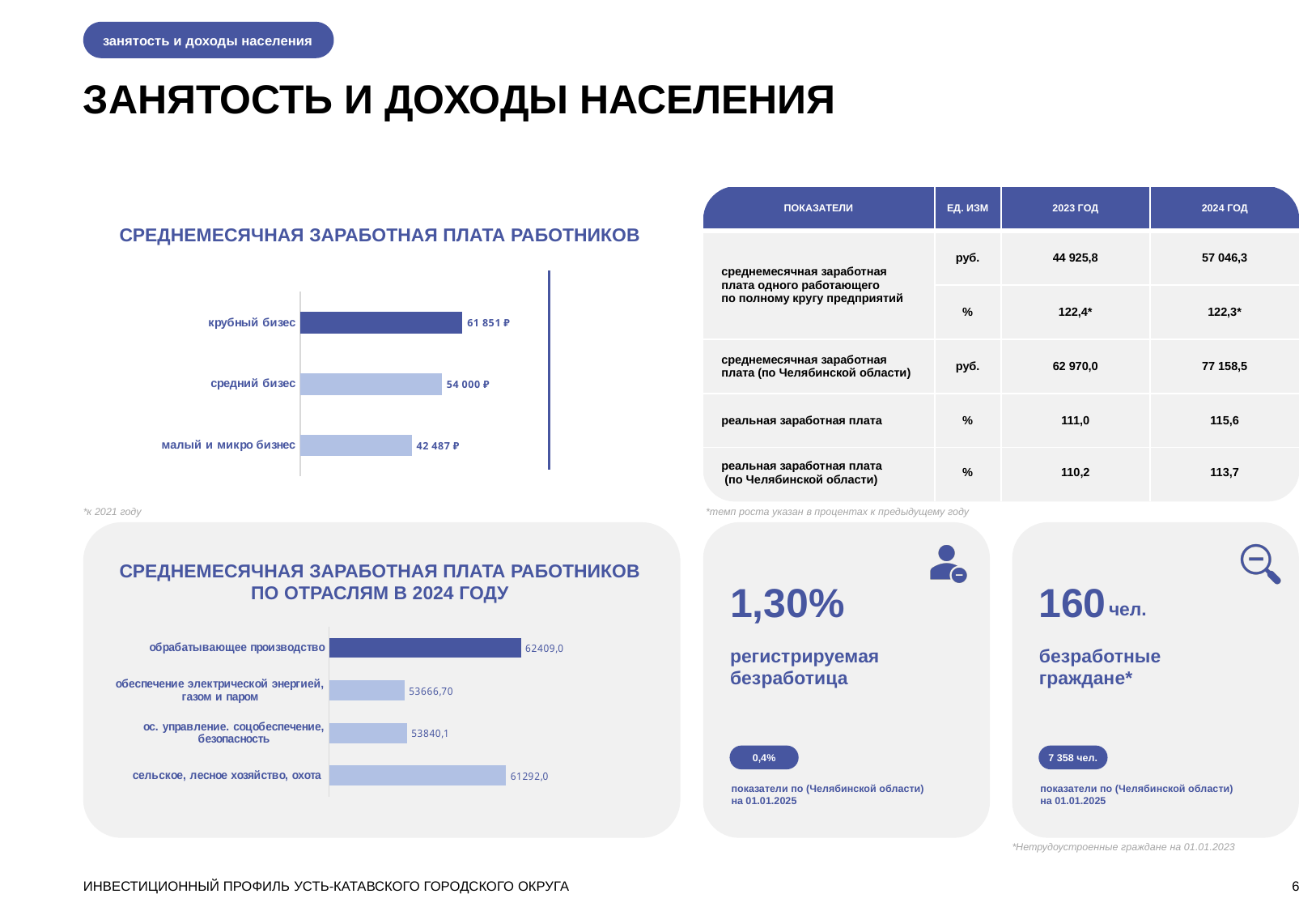
In the chart 'СРЕДНЕМЕСЯЧНАЯ ЗАРАБОТНАЯ ПЛАТА РАБОТНИКОВ', what is the value for 'малый и микро бизнес'? 42 487 ₽ In the chart 'СРЕДНЕМЕСЯЧНАЯ ЗАРАБОТНАЯ ПЛАТА РАБОТНИКОВ ПО ОТРАСЛЯМ В 2024 ГОДУ', what is the value for 'обеспечение электрической энергией, газом и паром'? 53666,70 In the chart 'СРЕДНЕМЕСЯЧНАЯ ЗАРАБОТНАЯ ПЛАТА РАБОТНИКОВ ПО ОТРАСЛЯМ В 2024 ГОДУ', which category has the highest value? обрабатывающее производство In the chart 'СРЕДНЕМЕСЯЧНАЯ ЗАРАБОТНАЯ ПЛАТА РАБОТНИКОВ ПО ОТРАСЛЯМ В 2024 ГОДУ', what is the value for 'сельское, лесное хозяйство, охота'? 61292,0 In the chart 'СРЕДНЕМЕСЯЧНАЯ ЗАРАБОТНАЯ ПЛАТА РАБОТНИКОВ ПО ОТРАСЛЯМ В 2024 ГОДУ', which is larger: 'обрабатывающее производство' or 'ос. управление. соцобеспечение, безопасность'? обрабатывающее производство In the chart 'СРЕДНЕМЕСЯЧНАЯ ЗАРАБОТНАЯ ПЛАТА РАБОТНИКОВ', what is the difference between 'крубный бизес' and 'средний бизес'? 7 851 ₽ How many categories are shown in the chart 'СРЕДНЕМЕСЯЧНАЯ ЗАРАБОТНАЯ ПЛАТА РАБОТНИКОВ'? 3 In the chart 'СРЕДНЕМЕСЯЧНАЯ ЗАРАБОТНАЯ ПЛАТА РАБОТНИКОВ ПО ОТРАСЛЯМ В 2024 ГОДУ', what is the value for 'обрабатывающее производство'? 62409,0 In the chart 'СРЕДНЕМЕСЯЧНАЯ ЗАРАБОТНАЯ ПЛАТА РАБОТНИКОВ', which category has the lowest value? малый и микро бизнес How many categories are shown in the chart 'СРЕДНЕМЕСЯЧНАЯ ЗАРАБОТНАЯ ПЛАТА РАБОТНИКОВ ПО ОТРАСЛЯМ В 2024 ГОДУ'? 4 What type of chart is 'СРЕДНЕМЕСЯЧНАЯ ЗАРАБОТНАЯ ПЛАТА РАБОТНИКОВ'? bar chart In the chart 'СРЕДНЕМЕСЯЧНАЯ ЗАРАБОТНАЯ ПЛАТА РАБОТНИКОВ', what is the value for 'крубный бизес'? 61 851 ₽